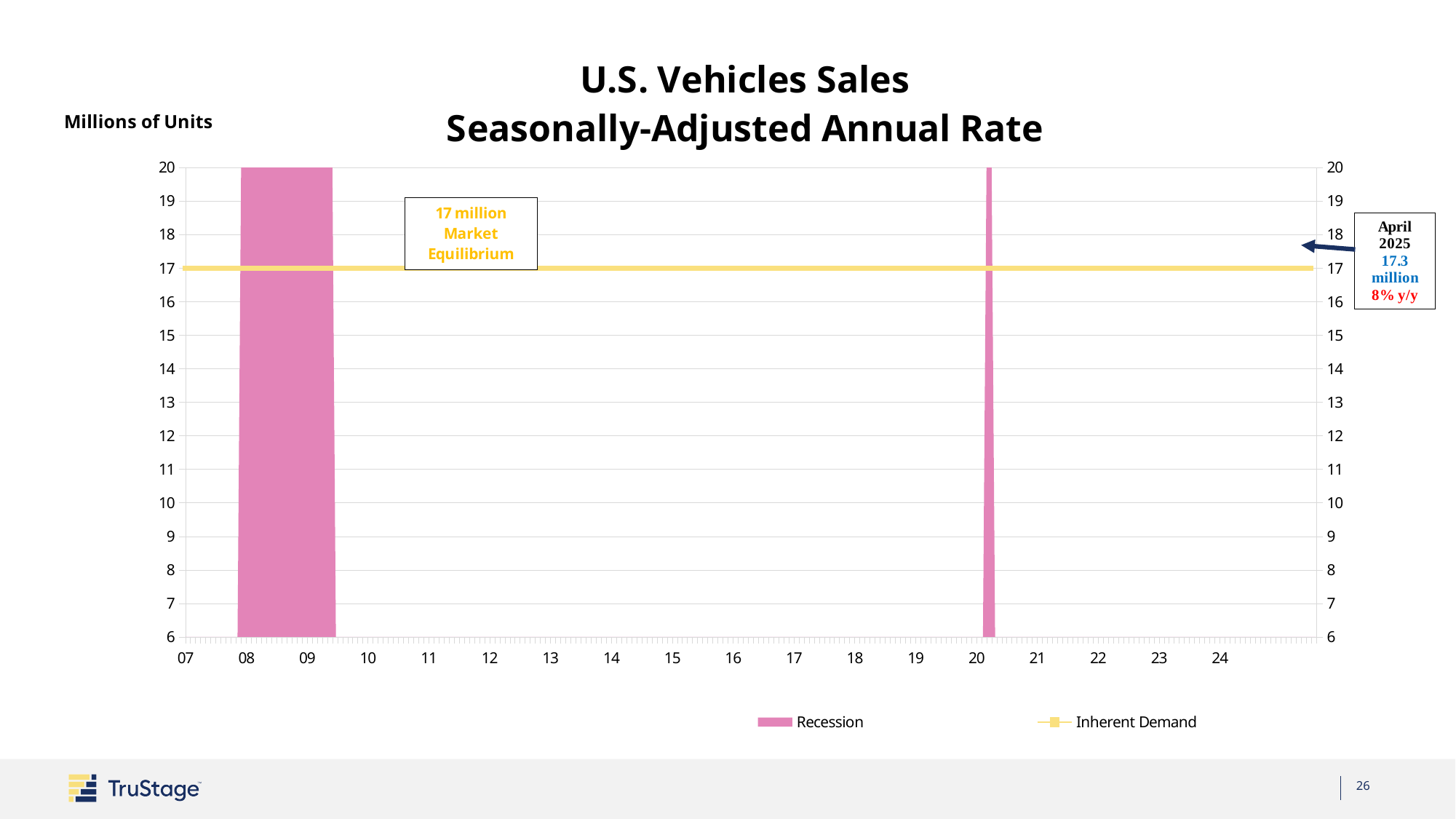
Is the Inherent Demand value greater or less than 15? greater What year-over-year change is annotated for April 2025? 8% y/y How many recession periods are shaded on the chart? 2 Is the Inherent Demand value greater or less than 18? less How many series does the legend list? 2 At what level does the Inherent Demand line sit on the chart? 17 million What is the difference between the April 2025 value and the 17 million market equilibrium? 0.3 million What vehicle sales value is annotated for April 2025? 17.3 million Which is larger, the April 2025 value of 17.3 million or the 17 million market equilibrium? April 2025 value (17.3 million) What unit is shown for the y axis of the chart? Millions of Units What is the title of the chart? U.S. Vehicles Sales Seasonally-Adjusted Annual Rate Does the Inherent Demand line rise, fall, or stay flat across the x axis? stay flat